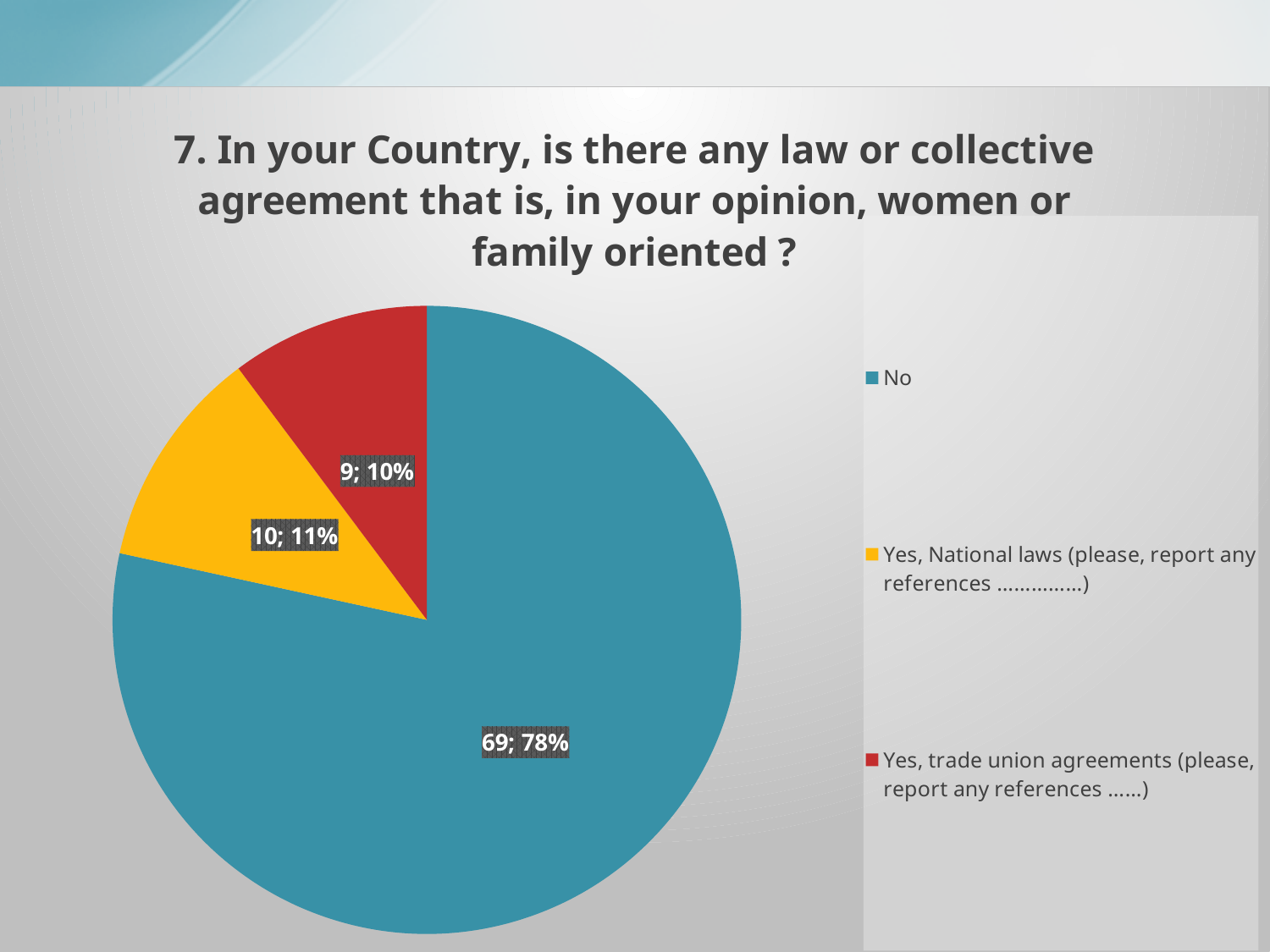
What percentage share does the "No" slice have? 78% Which category has the largest slice? No What is the count shown for the "Yes, trade union agreements" slice? 9 What is the difference in count between the "No" slice and the "Yes, National laws" slice? 59 What kind of chart is shown on the slide? pie chart Which colour represents the "No" category in the pie chart? blue How many entries does the legend list? 3 What percentage share does the "Yes, trade union agreements" slice have? 10% How many slices does the pie chart have? 3 What is the count shown for the "Yes, National laws" slice? 10 What percentage share does the "Yes, National laws" slice have? 11% What is the count shown for the "No" slice? 69